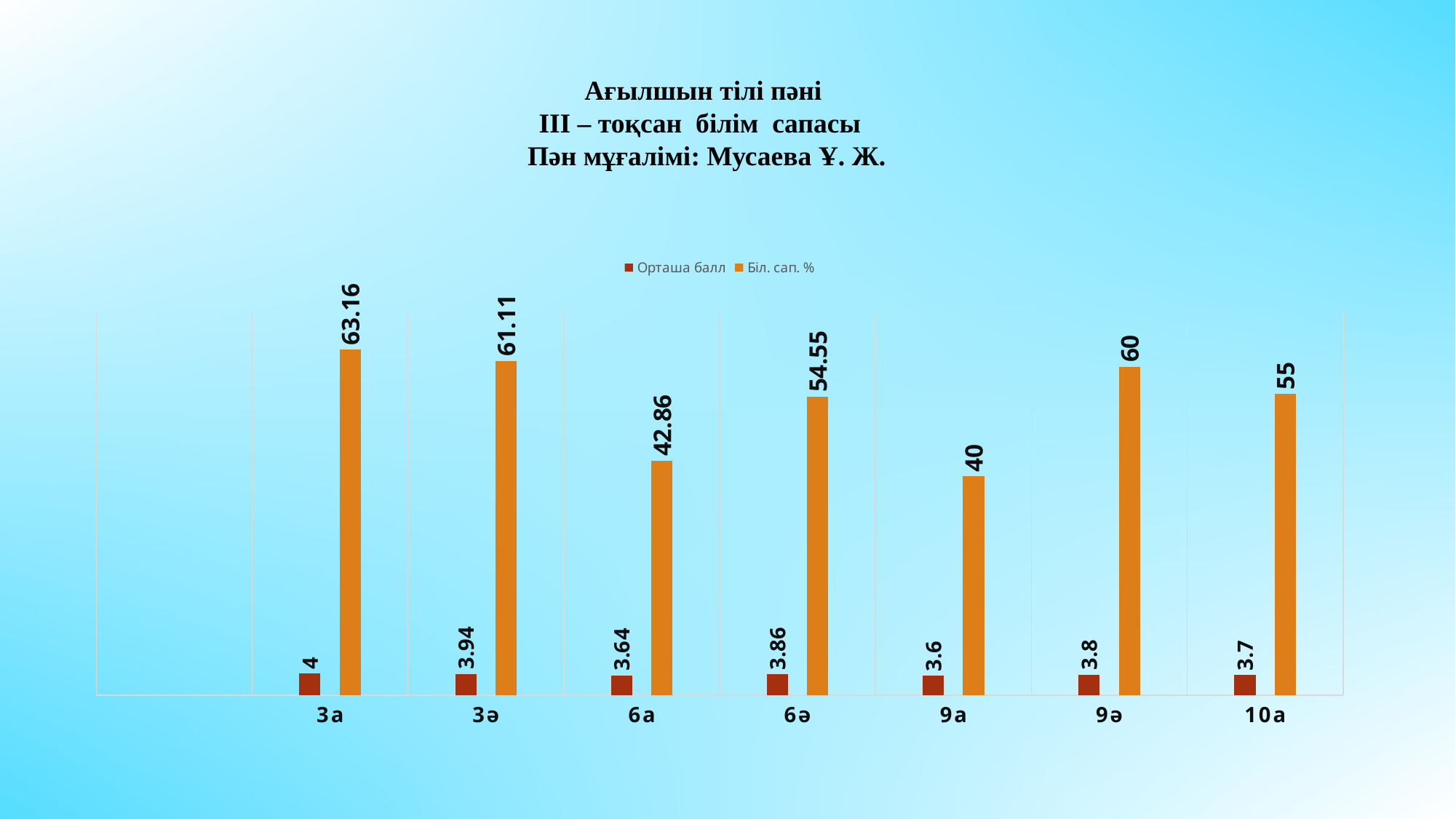
Which category has the lowest Біл. сап. % value? 9а What is the Біл. сап. % value for 3а? 63.16 Which is larger, the Біл. сап. % value for 6а or for 6ә? 6ә How many categories are shown on the x axis? 7 Which category has the highest Біл. сап. % value? 3а What is the difference between the Біл. сап. % values for 3а and 10а? 8.16 What is the Орташа балл value for 6ә? 3.86 What kind of chart is shown on the slide? bar chart What are the two series names listed in the legend? Орташа балл and Біл. сап. % How many series does the legend list? 2 What is the Біл. сап. % value for 9ә? 60 Which category has the lowest Орташа балл value? 9а